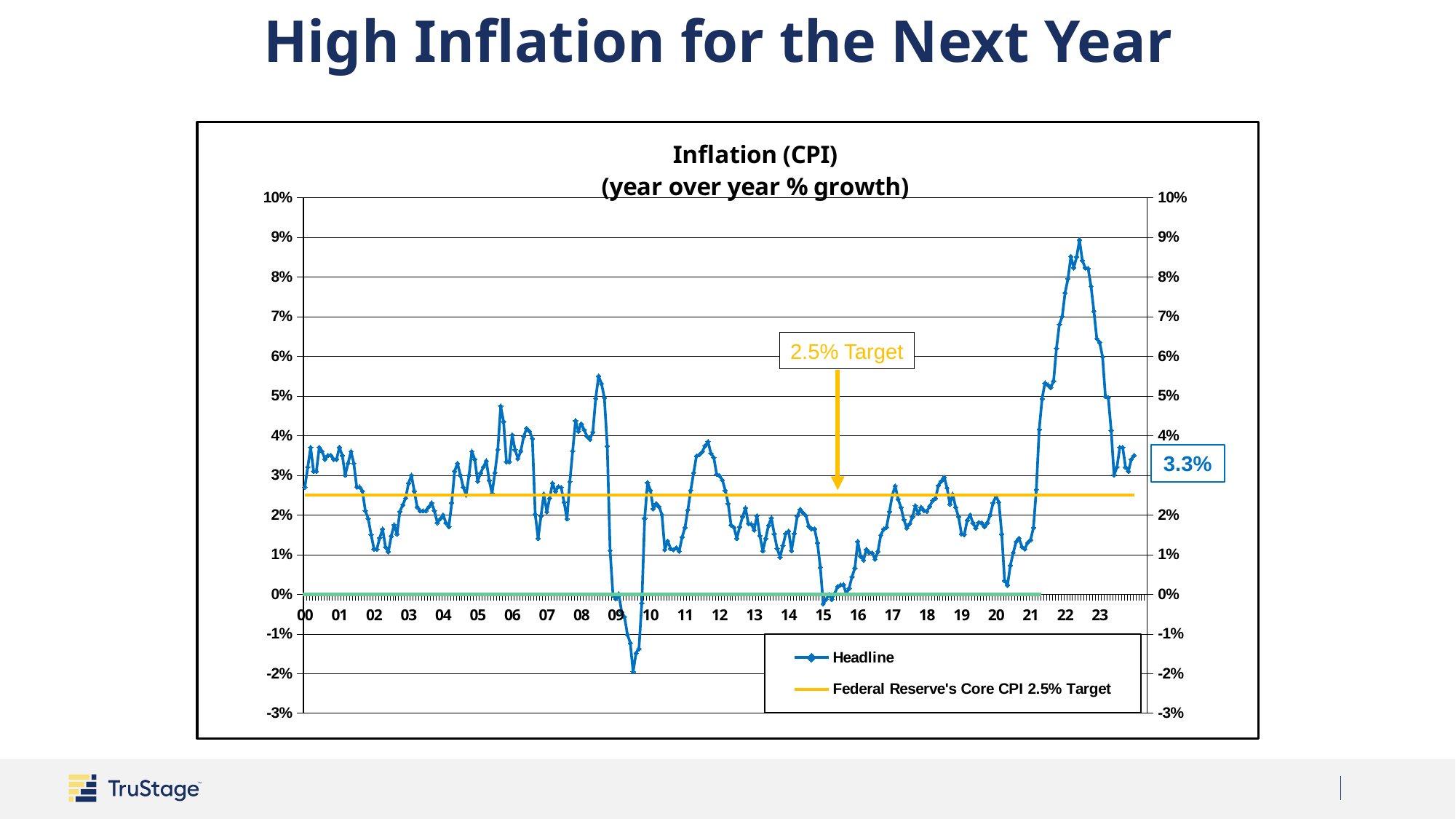
How many series does the legend list? 2 In which year does the Headline series reach its lowest value? 09 What kind of chart is shown on the slide? line chart By how much does the latest Headline value of 3.3% exceed the 2.5% target? 0.8% Do Headline inflation values rise or fall from 2022 to 2023? fall Is the lowest value of the Headline series in 2009 greater or less than -1%? less Which is larger, the latest Headline value of 3.3% or the 2.5% target? 3.3% What is the most recent Headline inflation value labeled on the chart? 3.3% Is the peak value of the Headline series in 2022 greater or less than 8%? greater What is the title of the chart? Inflation (CPI) (year over year % growth) In which year does the Headline series reach its highest value? 22 What is the Federal Reserve's Core CPI target shown on the chart? 2.5%